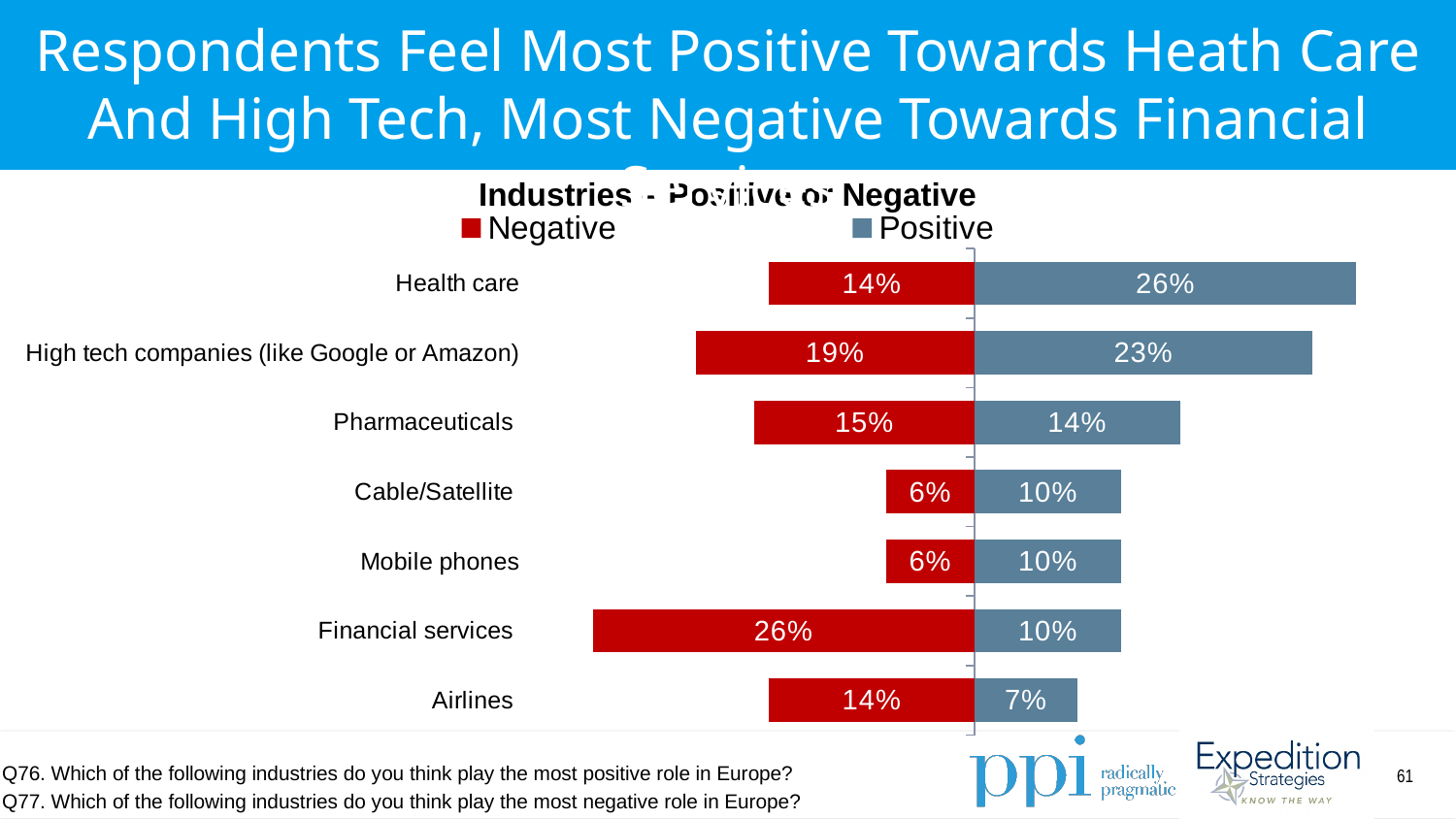
How many industries are shown in the chart? 7 Which is larger for Pharmaceuticals, the Negative value or the Positive value? Negative What is the Positive value for Airlines? 7% Which industry has the highest Positive value? Health care What is the Negative value for Financial services? 26% What is the difference between the Positive and Negative values for Financial services? 16% What is the Positive value for Health care? 26% What is the Negative value for High tech companies (like Google or Amazon)? 19% What kind of chart is shown on the slide? Bar chart Which industry has the highest Negative value? Financial services Which industry has the lowest Positive value? Airlines How many series does the legend list? 2